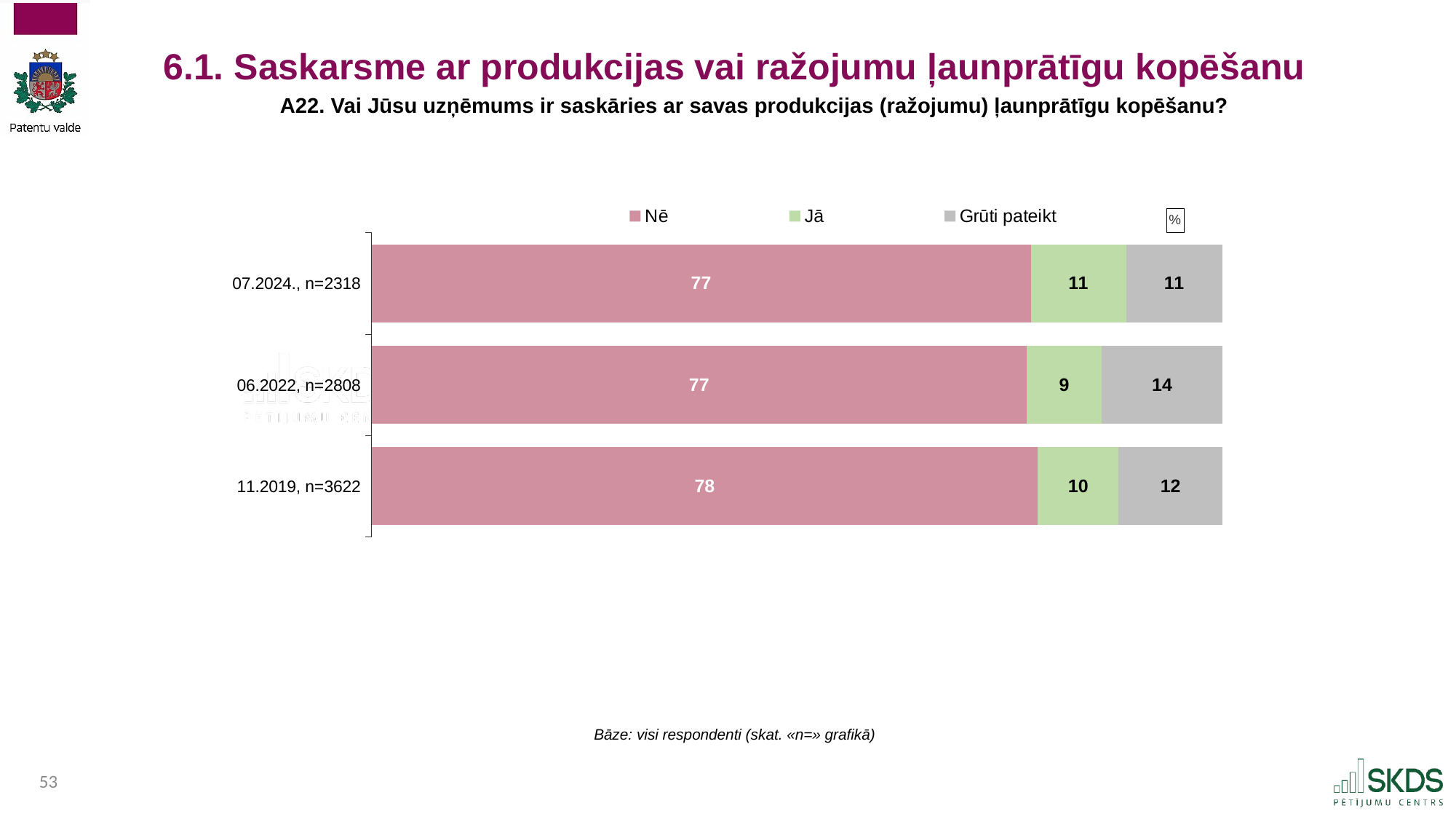
How many survey waves (bars) are shown in the chart? 3 What kind of chart is shown on the slide? Stacked bar chart What is the value for "Jā" in the 11.2019, n=3622 bar? 10 What is the value for "Jā" in the 06.2022, n=2808 bar? 9 What is the difference between the "Grūti pateikt" values for 06.2022, n=2808 and 11.2019, n=3622? 2 How many series does the legend list? 3 Which survey wave has the lowest value for "Jā"? 06.2022, n=2808 Which is larger: the "Jā" value for 07.2024., n=2318 or for 06.2022, n=2808? 07.2024., n=2318 What is the value for "Nē" in the 07.2024., n=2318 bar? 77 Which legend entry is shown in green? Jā Which survey wave has the highest value for "Grūti pateikt"? 06.2022, n=2808 What is the value for "Grūti pateikt" in the 11.2019, n=3622 bar? 12